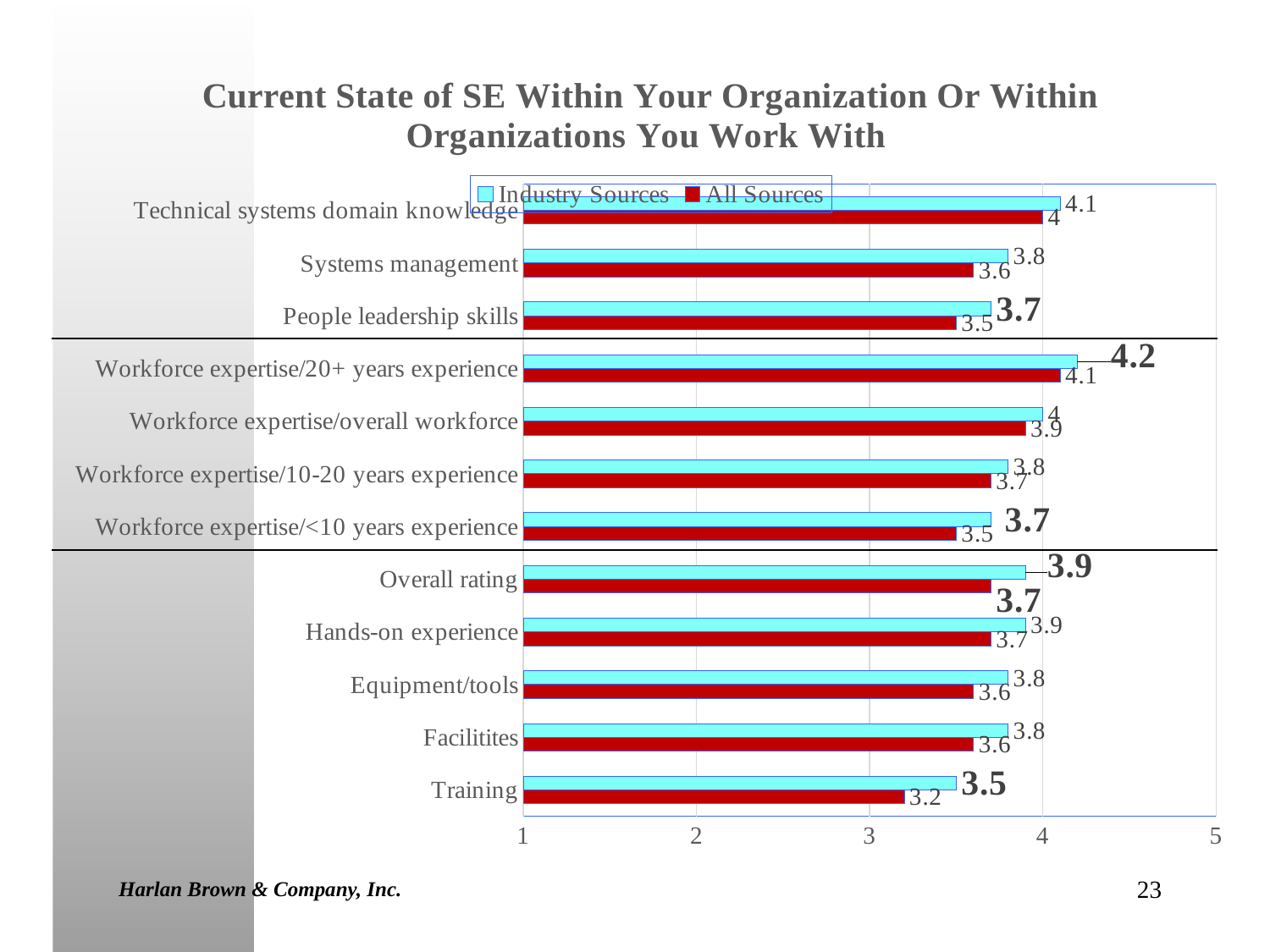
What is the All Sources value for Training? 3.2 Which is larger for Systems management: the Industry Sources value or the All Sources value? Industry Sources Which category has the lowest All Sources value? Training How many categories are shown on the chart? 12 What is the difference between the Industry Sources and All Sources values for Training? 0.3 Which category has the highest Industry Sources value? Workforce expertise/20+ years experience What is the Industry Sources value for Workforce expertise/20+ years experience? 4.2 What is the All Sources value for Equipment/tools? 3.6 What kind of chart is shown on the slide? Bar chart How many series does the legend list? 2 Is the All Sources value for Workforce expertise/20+ years experience greater or less than 4? greater What is the Industry Sources value for Technical systems domain knowledge? 4.1